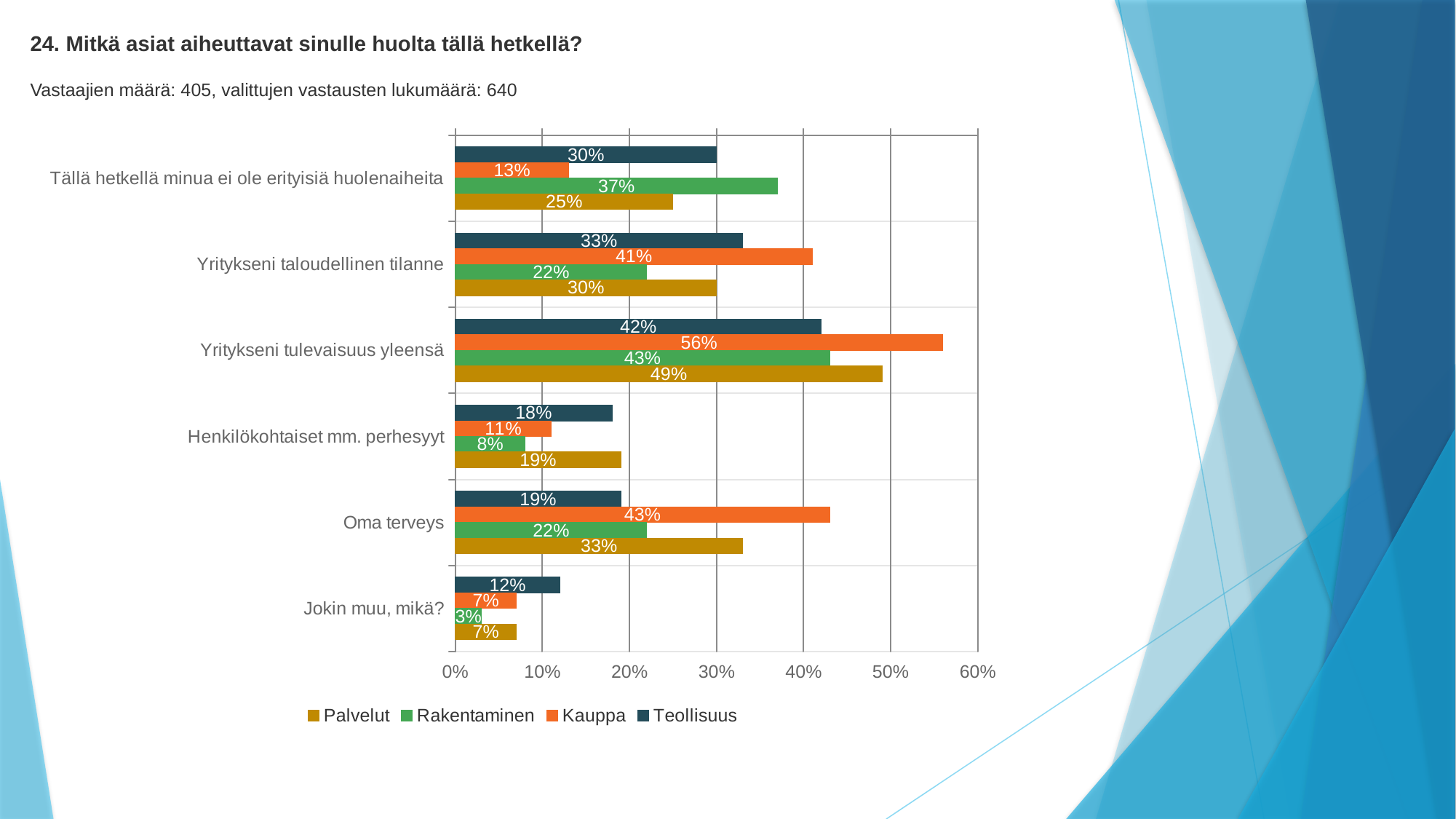
What is the value for Teollisuus in the category "Henkilökohtaiset mm. perhesyyt"? 18% What is the value for Palvelut in the category "Oma terveys"? 33% What is the value for Kauppa in the category "Yritykseni tulevaisuus yleensä"? 56% What is the difference between the Kauppa and Teollisuus values in the category "Oma terveys"? 24% Which category has the lowest value for the Rakentaminen series? Jokin muu, mikä? Which series is shown in orange in the legend? Kauppa Which category has the highest value for the Kauppa series? Yritykseni tulevaisuus yleensä What kind of chart is shown on the slide? Bar chart How many series does the legend list? 4 In the category "Yritykseni taloudellinen tilanne", which is larger: the Kauppa value or the Rakentaminen value? Kauppa What is the value for Rakentaminen in the category "Tällä hetkellä minua ei ole erityisiä huolenaiheita"? 37% How many categories are shown on the chart? 6